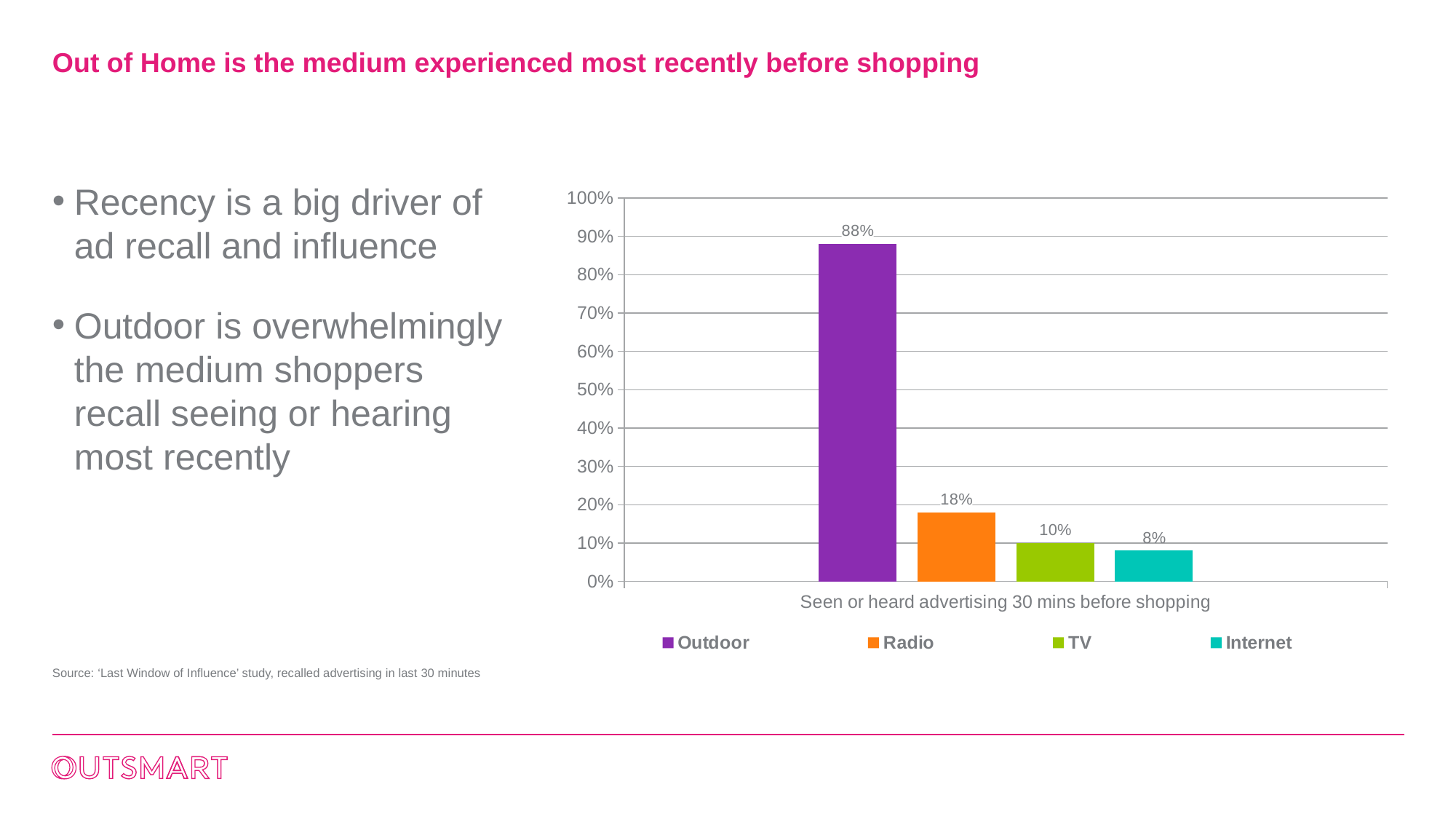
What is the value for Radio in the chart? 18% How many series does the legend list? 4 What is the value for TV in the chart? 10% What is the label on the x axis of the chart? Seen or heard advertising 30 mins before shopping What is the value for Internet in the chart? 8% Which medium has the highest value in the chart? Outdoor What is the difference between the values for Outdoor and Radio? 70% Which is larger, the value for Radio or the value for TV? Radio Which medium has the lowest value in the chart? Internet What kind of chart is shown on the slide? Bar chart What is the value for Outdoor in the chart? 88% Is the value for Outdoor greater or less than 80%? greater